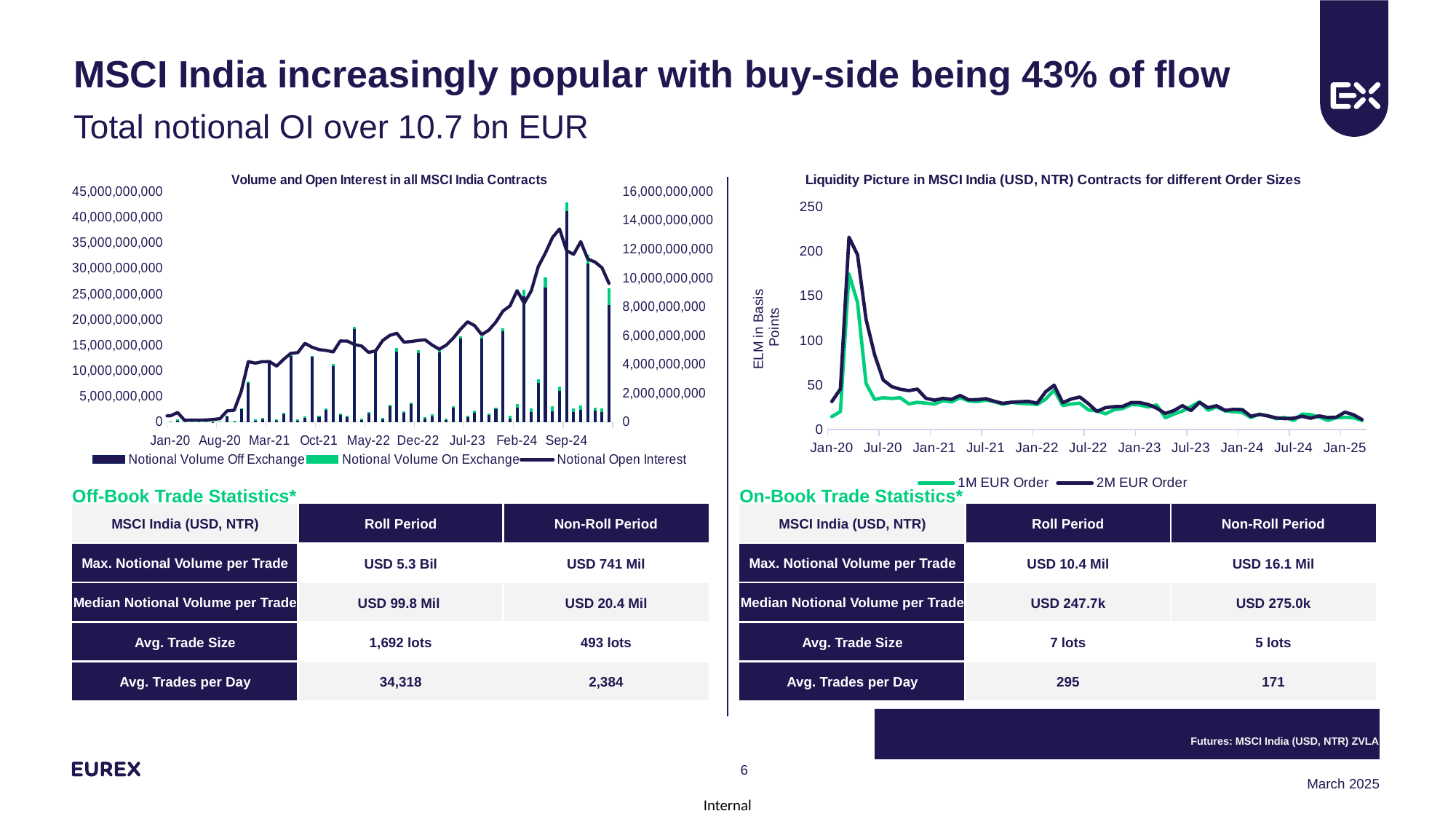
How many series does the legend of the 'Volume and Open Interest in all MSCI India Contracts' chart list? 3 In the 'Liquidity Picture' chart, which series reaches the higher peak in 2020, 1M EUR Order or 2M EUR Order? 2M EUR Order In the 'Liquidity Picture' chart, is the peak value of the 1M EUR Order series greater or less than 200? less In the 'Volume and Open Interest in all MSCI India Contracts' chart, does Notional Open Interest generally rise or fall from Jan-20 to Sep-24? Rise What kind of chart is the 'Volume and Open Interest in all MSCI India Contracts' chart? A combination bar and line chart What kind of chart is the 'Liquidity Picture in MSCI India (USD, NTR) Contracts for different Order Sizes' chart? A line chart In the 'Liquidity Picture' chart, is the value of the 2M EUR Order series at Jan-25 greater or less than 50? less How many series does the legend of the 'Liquidity Picture in MSCI India (USD, NTR) Contracts for different Order Sizes' chart list? 2 In the 'Liquidity Picture' chart, do the ELM values generally rise or fall from Jul-20 to Jan-25? Fall What is the y-axis label of the 'Liquidity Picture in MSCI India (USD, NTR) Contracts for different Order Sizes' chart? ELM in Basis Points In the 'Volume and Open Interest in all MSCI India Contracts' chart, which series is drawn as a line? Notional Open Interest In the 'Liquidity Picture' chart, is the peak value of the 2M EUR Order series greater or less than 200? greater